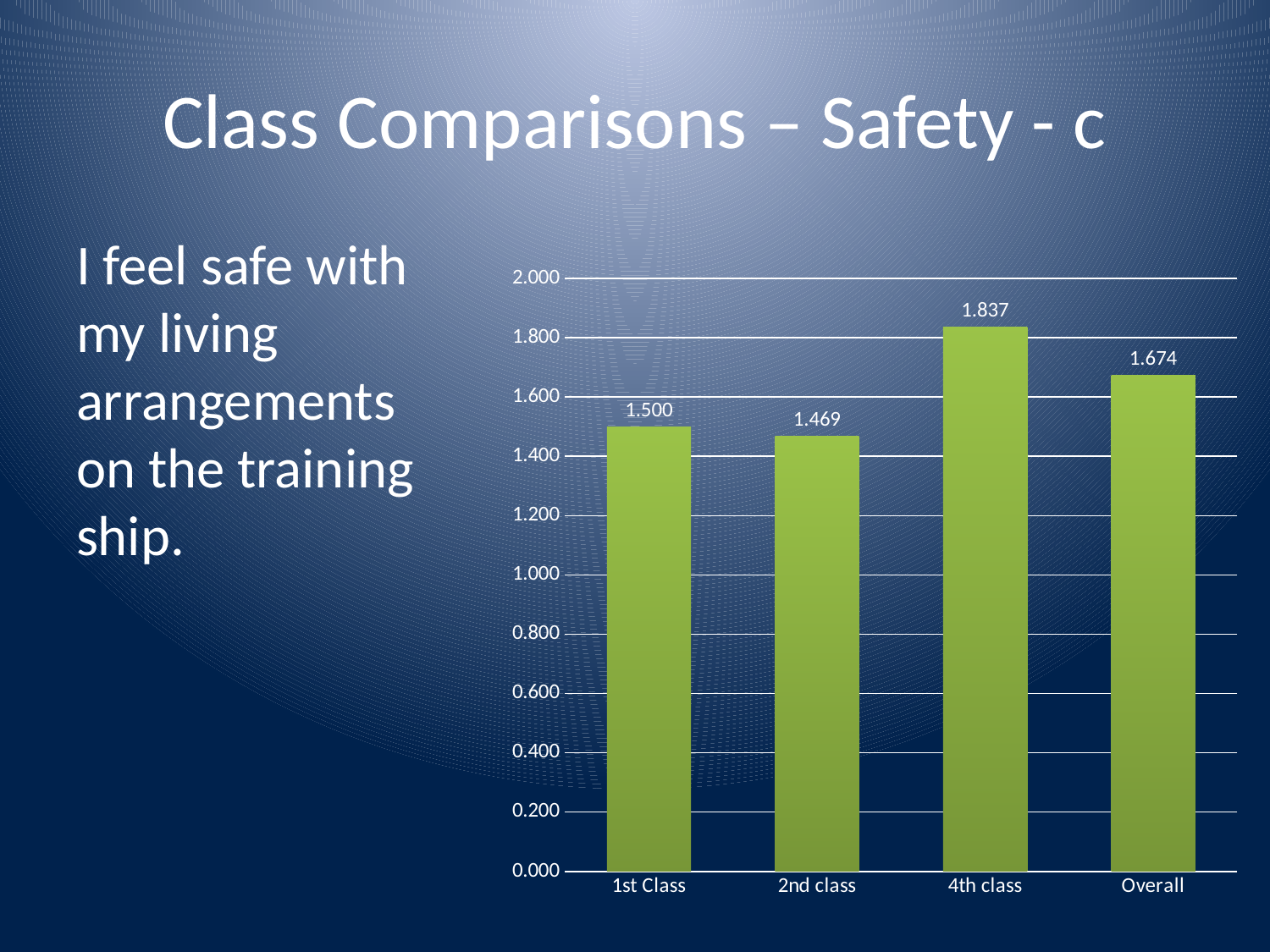
What is the value for 2nd class? 1.469 How many categories are shown on the x axis? 4 Which category has the highest value? 4th class Is the value for 2nd class greater or less than 1.600? less What is the difference between the values for 4th class and 1st Class? 0.337 Which is larger, the value for 4th class or the value for Overall? 4th class What is the value for Overall? 1.674 What is the value for 1st Class? 1.500 What is the difference between the values for Overall and 2nd class? 0.205 What is the value for 4th class? 1.837 Which category has the lowest value? 2nd class What kind of chart is shown on the slide? bar chart